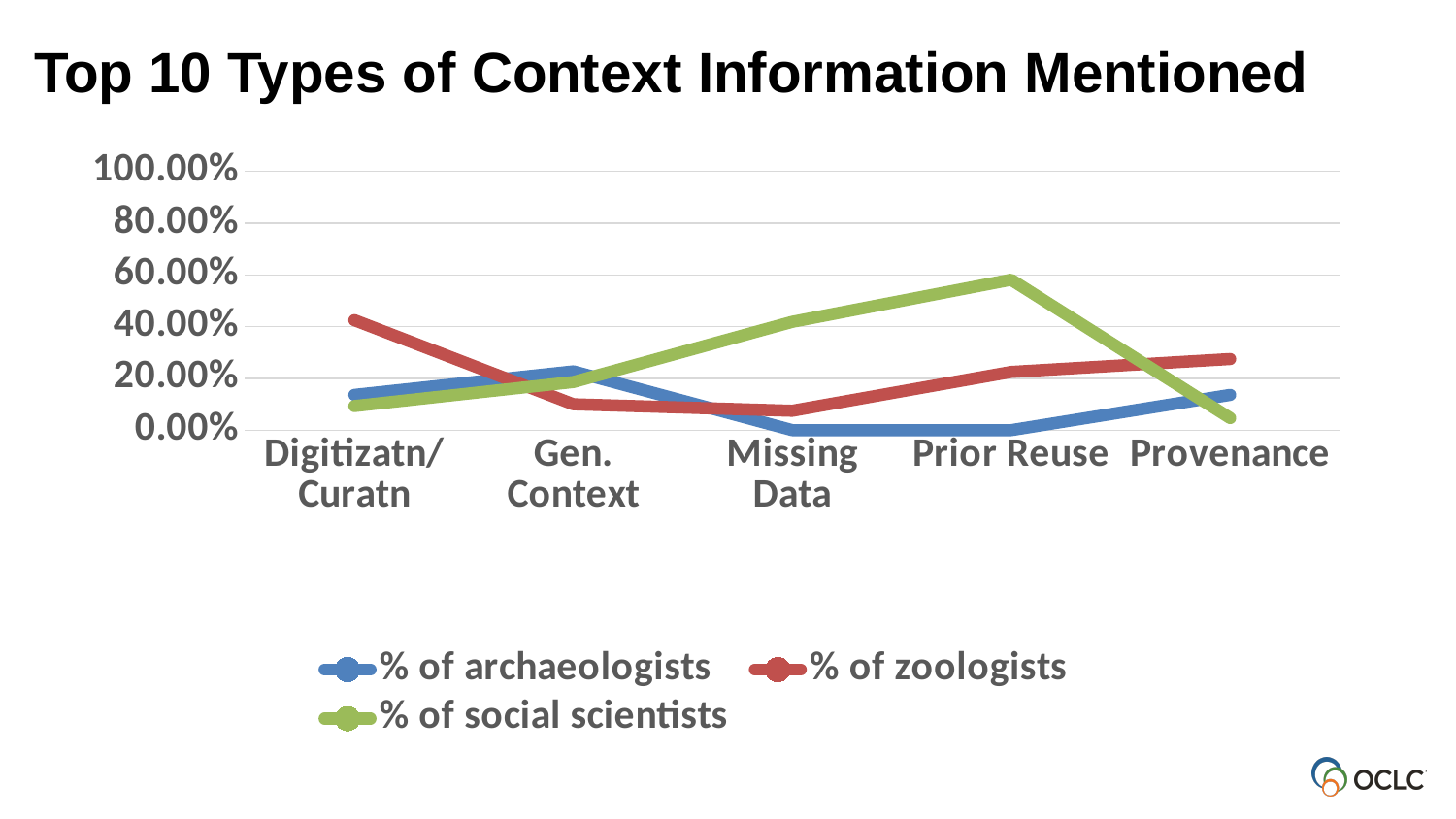
Is the % of zoologists for Digitizatn/Curatn greater or less than 20.00%? greater Which series is drawn in green? % of social scientists For which category is the % of social scientists highest? Prior Reuse For Missing Data, which series has the higher value: % of social scientists or % of zoologists? % of social scientists Is the % of social scientists for Prior Reuse greater or less than 40.00%? greater What is the title of the chart? Top 10 Types of Context Information Mentioned How many categories are shown along the x axis? 5 What kind of chart is shown on the slide? Line chart How many series does the legend list? 3 For which category is the % of zoologists highest? Digitizatn/Curatn Does the % of social scientists rise or fall from Prior Reuse to Provenance? Fall For which category is the % of social scientists lowest? Provenance